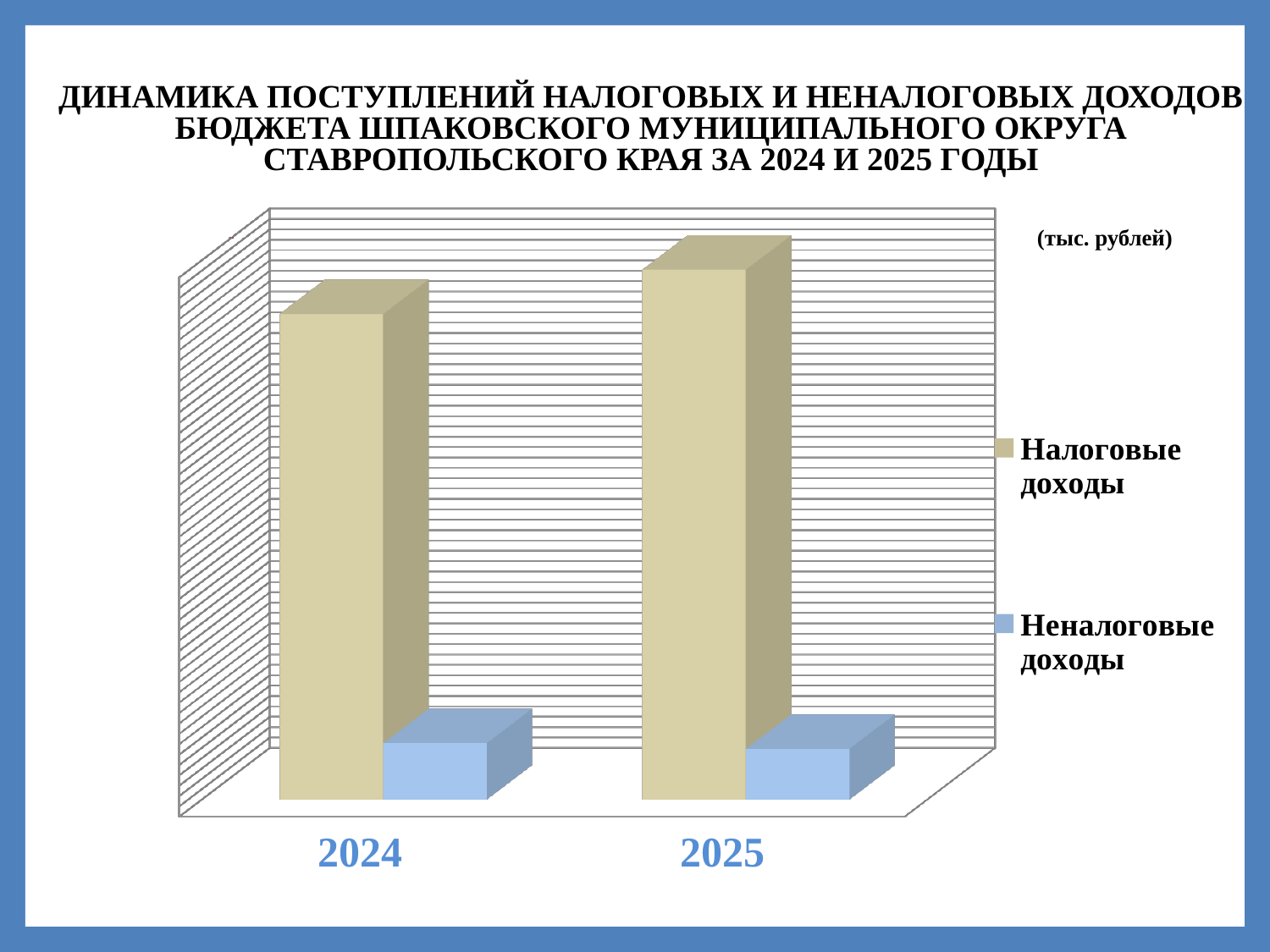
How many series does the chart's legend list? 2 In 2025, which is larger: Налоговые доходы or Неналоговые доходы? Налоговые доходы Which year has the lower value for Налоговые доходы, 2024 or 2025? 2024 Which series has the smallest bar on the chart overall? Неналоговые доходы What kind of chart is shown on the slide? Bar chart Do the values for Налоговые доходы rise or fall from 2024 to 2025? Rise How many years (categories) are shown on the x axis of the chart? 2 In 2024, which is larger: Налоговые доходы or Неналоговые доходы? Налоговые доходы Which two series are listed in the chart's legend? Налоговые доходы and Неналоговые доходы In what units are the values of the chart expressed, according to the note on the slide? тыс. рублей Which year has the higher value for Налоговые доходы, 2024 or 2025? 2025